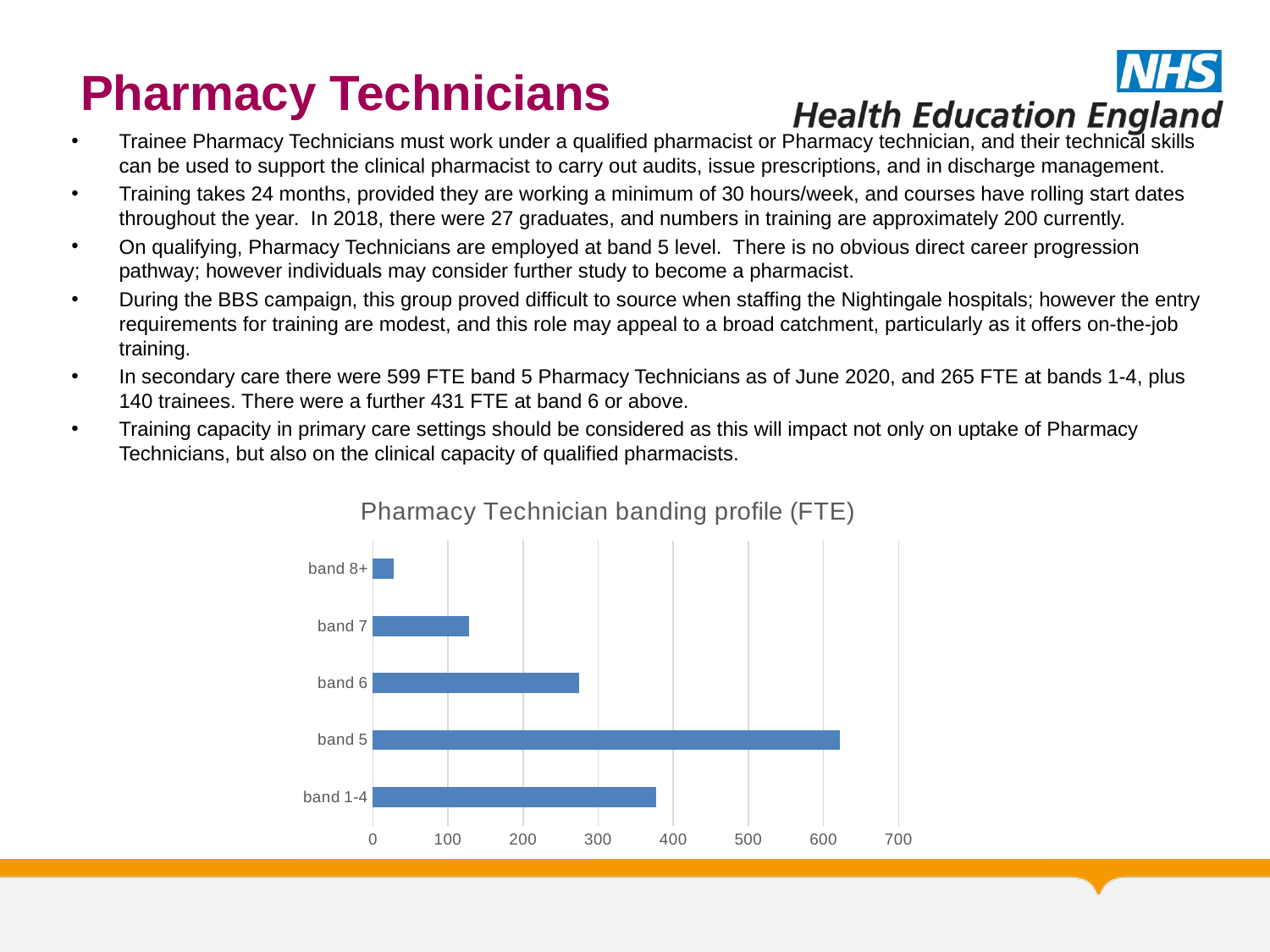
How many bands (categories) are plotted in the chart? 5 Is the value for band 8+ greater or less than 100? less Is the value for band 6 greater or less than 300? less What is the title of the chart? Pharmacy Technician banding profile (FTE) Is the value for band 5 greater or less than 600? greater Which band has the lowest FTE value in the chart? band 8+ Which has a larger FTE value, band 6 or band 1-4? band 1-4 Which has a larger FTE value, band 7 or band 6? band 6 What is the maximum value shown on the horizontal axis of the chart? 700 Which band has the highest FTE value in the chart? band 5 What kind of chart is shown on the slide? bar chart